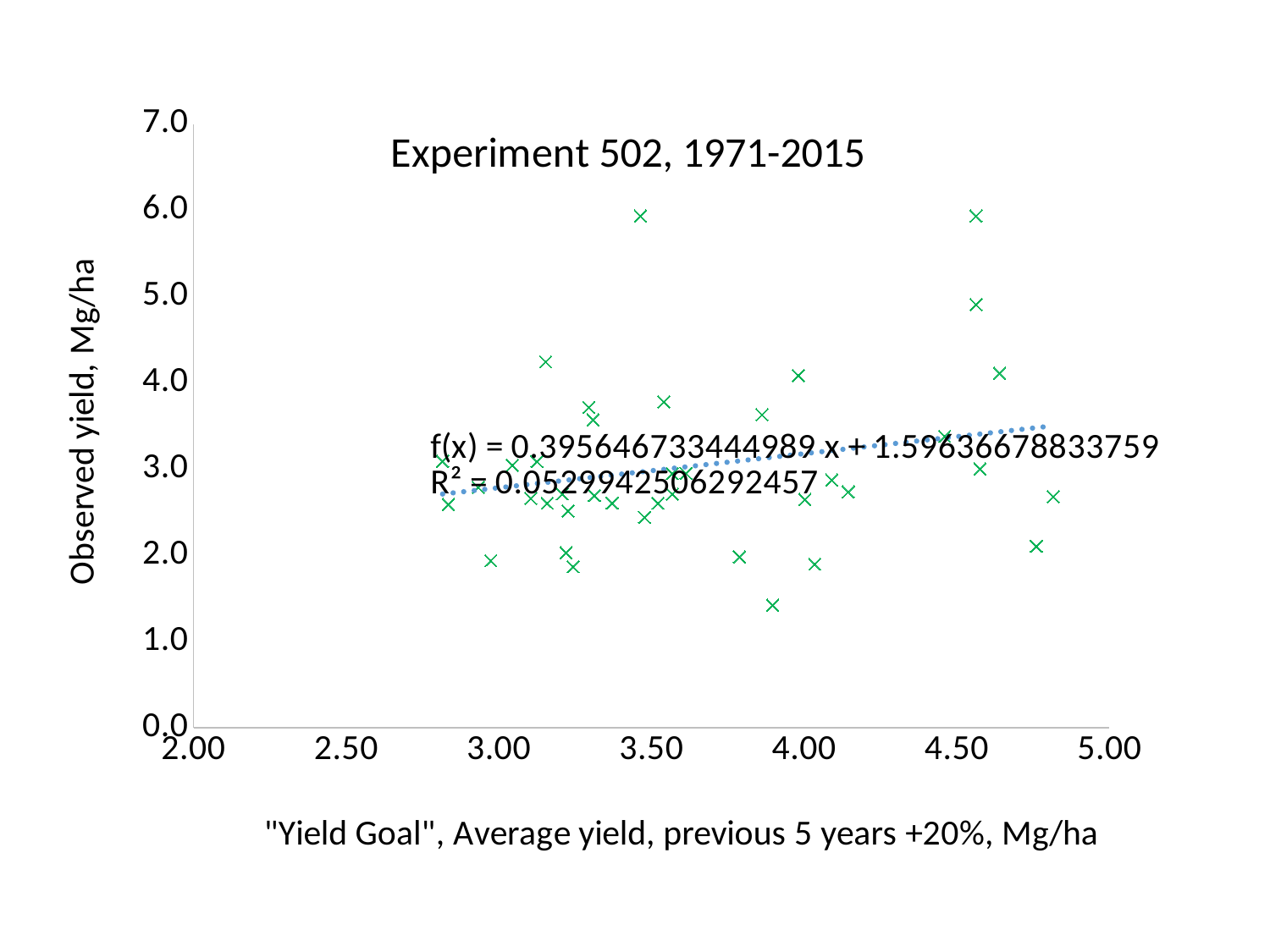
According to the trendline, do observed yields rise or fall as the yield goal increases? Rise What is the slope of the fitted line f(x) shown on the chart? 0.395646733444989 What is the maximum value shown on the horizontal axis? 5.00 Is the highest observed yield plotted greater or less than 5.0 Mg/ha? greater Is the lowest observed yield plotted greater or less than 2.0 Mg/ha? less What is the title of the chart? Experiment 502, 1971-2015 What is the label of the vertical axis? Observed yield, Mg/ha What kind of chart is shown on the slide? Scatter chart What is the intercept of the fitted line f(x) shown on the chart? 1.59636678833759 What is the maximum value shown on the vertical axis? 7.0 What R² value is printed for the trendline? 0.0529942506292457